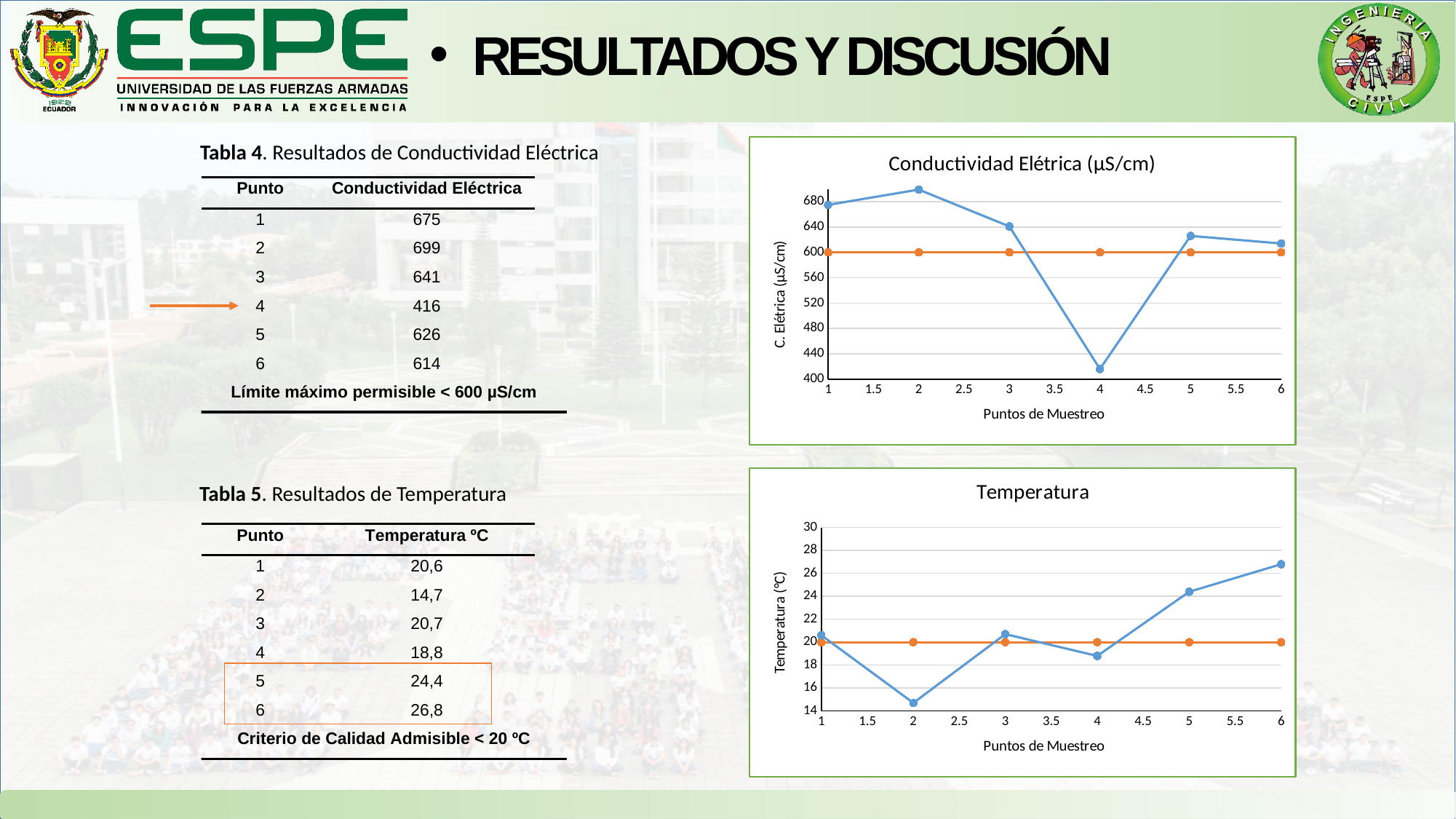
In the 'Temperatura' chart, which sampling point has the lowest temperature? 2 In the 'Temperatura' chart, is the value at sampling point 2 greater or less than 16? less In the 'Conductividad Elétrica (µS/cm)' chart, is the value at sampling point 2 greater or less than 680? greater In the 'Conductividad Elétrica (µS/cm)' chart, how many sampling points are plotted on the blue line? 6 In the 'Conductividad Elétrica (µS/cm)' chart, which sampling point has the lowest conductivity? 4 In the 'Temperatura' chart, which sampling point has the highest temperature? 6 In the 'Conductividad Elétrica (µS/cm)' chart, what is the conductivity at sampling point 4, as given in Tabla 4? 416 What kind of chart is the 'Conductividad Elétrica (µS/cm)' chart? line chart In the 'Conductividad Elétrica (µS/cm)' chart, what is the x-axis title? Puntos de Muestreo In the 'Conductividad Elétrica (µS/cm)' chart, which sampling point has the highest conductivity? 2 In the 'Conductividad Elétrica (µS/cm)' chart, is the value at sampling point 4 greater or less than 440? less What kind of chart is the 'Temperatura' chart? line chart